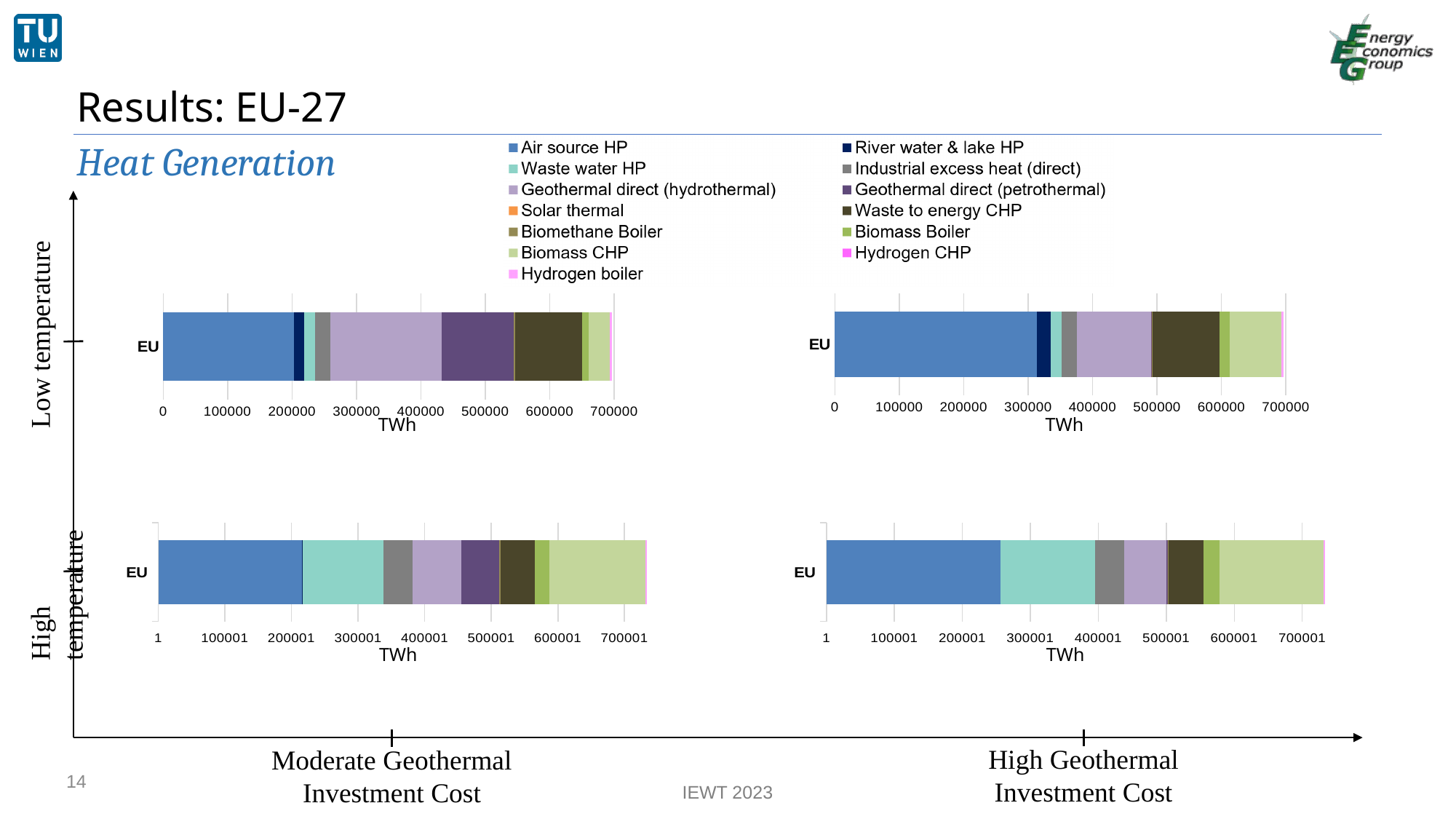
In the top-right chart (Low temperature, High Geothermal Investment Cost), which series has the largest segment in the EU bar? Air source HP In the bottom-right chart (High temperature, High Geothermal Investment Cost), which segment is larger: Waste water HP or Industrial excess heat (direct)? Waste water HP In the top-right chart (Low temperature, High Geothermal Investment Cost), is the Air source HP segment greater or less than 300000? greater What unit is shown on the x axis of the charts? TWh How many series does the shared legend list for the charts on the slide? 13 What is the category label on the y axis of the bottom-left chart (High temperature, Moderate Geothermal Investment Cost)? EU In the bottom-left chart (High temperature, Moderate Geothermal Investment Cost), which segment is larger: Biomass CHP or Biomass Boiler? Biomass CHP In the top-left chart (Low temperature, Moderate Geothermal Investment Cost), which segment is larger: Geothermal direct (hydrothermal) or Geothermal direct (petrothermal)? Geothermal direct (hydrothermal) In the bottom-right chart (High temperature, High Geothermal Investment Cost), is the Air source HP segment greater or less than 300001? less In the bottom-left chart (High temperature, Moderate Geothermal Investment Cost), is the total length of the EU bar greater or less than 600001? greater How many categories are plotted on the y axis of the top-right chart (Low temperature, High Geothermal Investment Cost)? 1 What kind of chart is the top-left chart (Low temperature, Moderate Geothermal Investment Cost)? Stacked bar chart